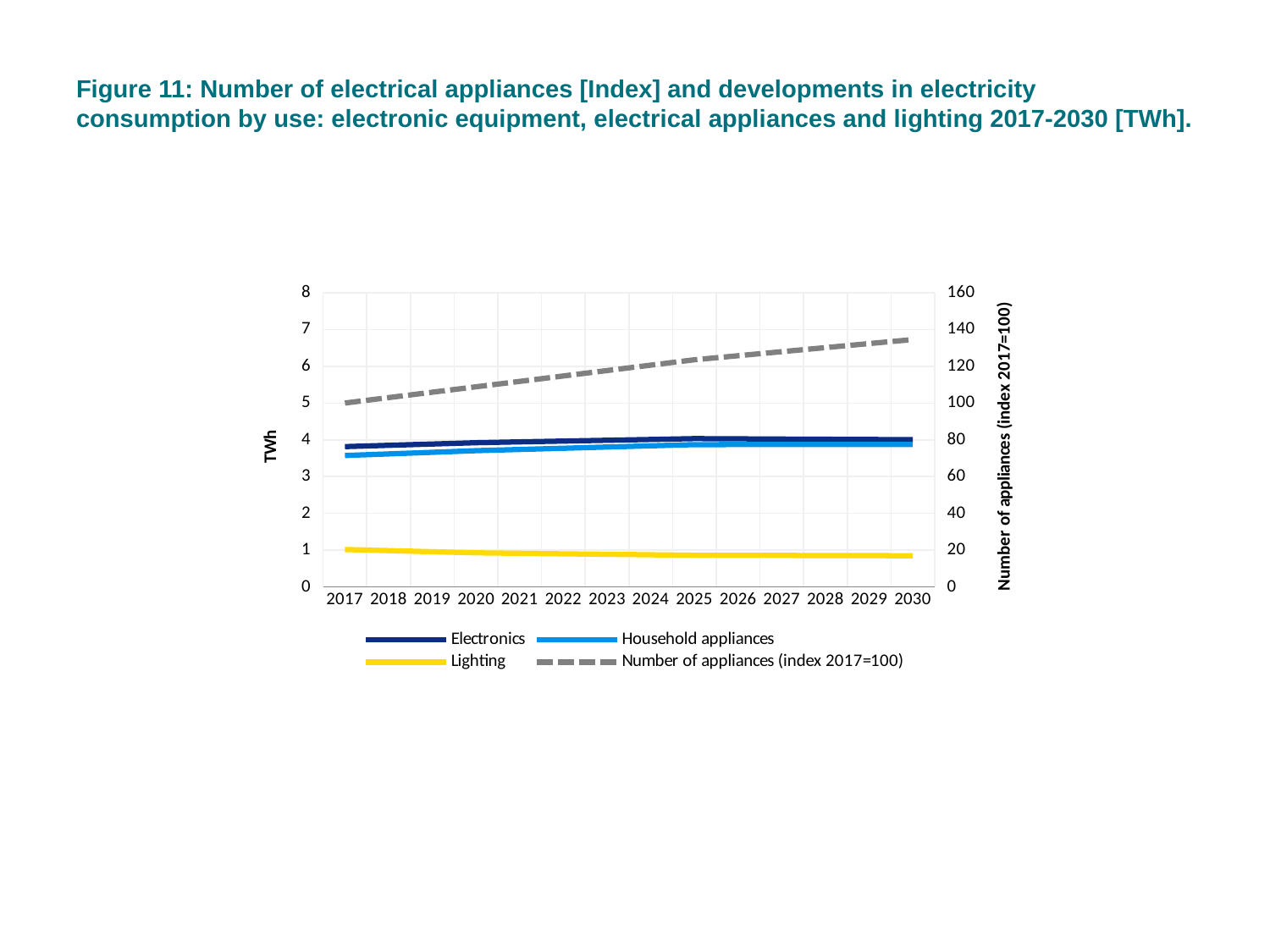
Which of the three TWh series has the lowest value in 2017? Lighting Is the value for Lighting in 2017 greater or less than 2? less How many series does the legend list? 4 Does the Number of appliances index rise or fall from 2017 to 2030? Rise Is the value for Electronics in 2030 greater or less than 3? greater Is the Number of appliances index in 2030 greater or less than 120? greater What is the value of the Number of appliances index in 2017? 100 How many years are shown along the x axis? 14 What is the label of the left vertical axis? TWh Does the Lighting series rise or fall from 2017 to 2030? Fall What kind of chart is shown on the slide? Line chart